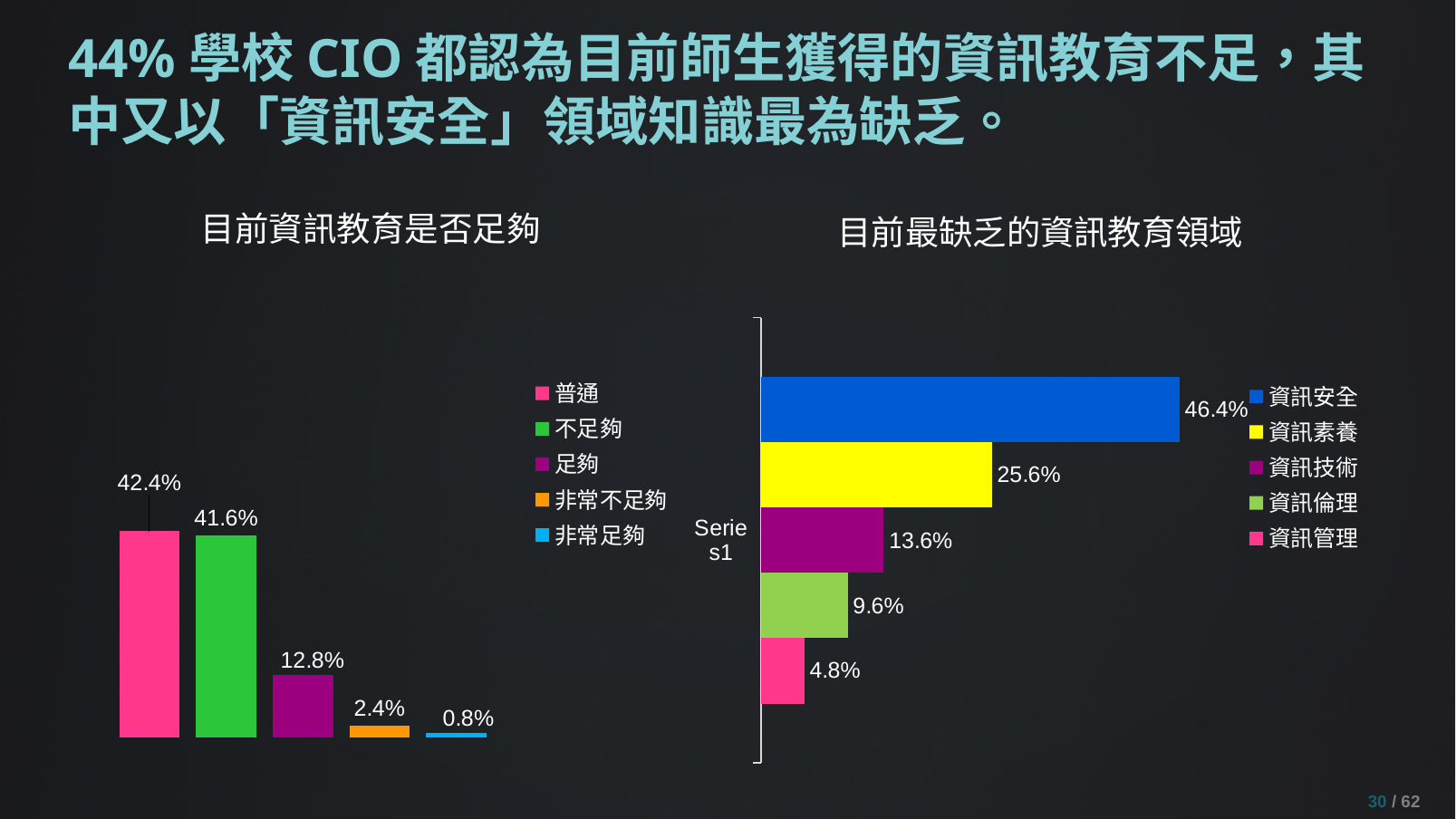
In the chart titled 目前資訊教育是否足夠, how many categories are shown? 5 In the chart titled 目前最缺乏的資訊教育領域, what is the value for 資訊倫理? 9.6% In the chart titled 目前資訊教育是否足夠, which category has the lowest value? 非常足夠 What kind of chart is the one titled 目前最缺乏的資訊教育領域? Bar chart In the chart titled 目前資訊教育是否足夠, what is the value for 普通? 42.4% In the chart titled 目前最缺乏的資訊教育領域, what colour is the bar for 資訊素養? Yellow In the chart titled 目前最缺乏的資訊教育領域, which category has the highest value? 資訊安全 In the chart titled 目前最缺乏的資訊教育領域, what is the difference between 資訊安全 and 資訊素養? 20.8% In the chart titled 目前資訊教育是否足夠, what is the value for 不足夠? 41.6% In the chart titled 目前資訊教育是否足夠, what is the difference between 足夠 and 非常不足夠? 10.4% In the chart titled 目前最缺乏的資訊教育領域, which is larger, 資訊素養 or 資訊技術? 資訊素養 In the chart titled 目前最缺乏的資訊教育領域, what is the value for 資訊安全? 46.4%